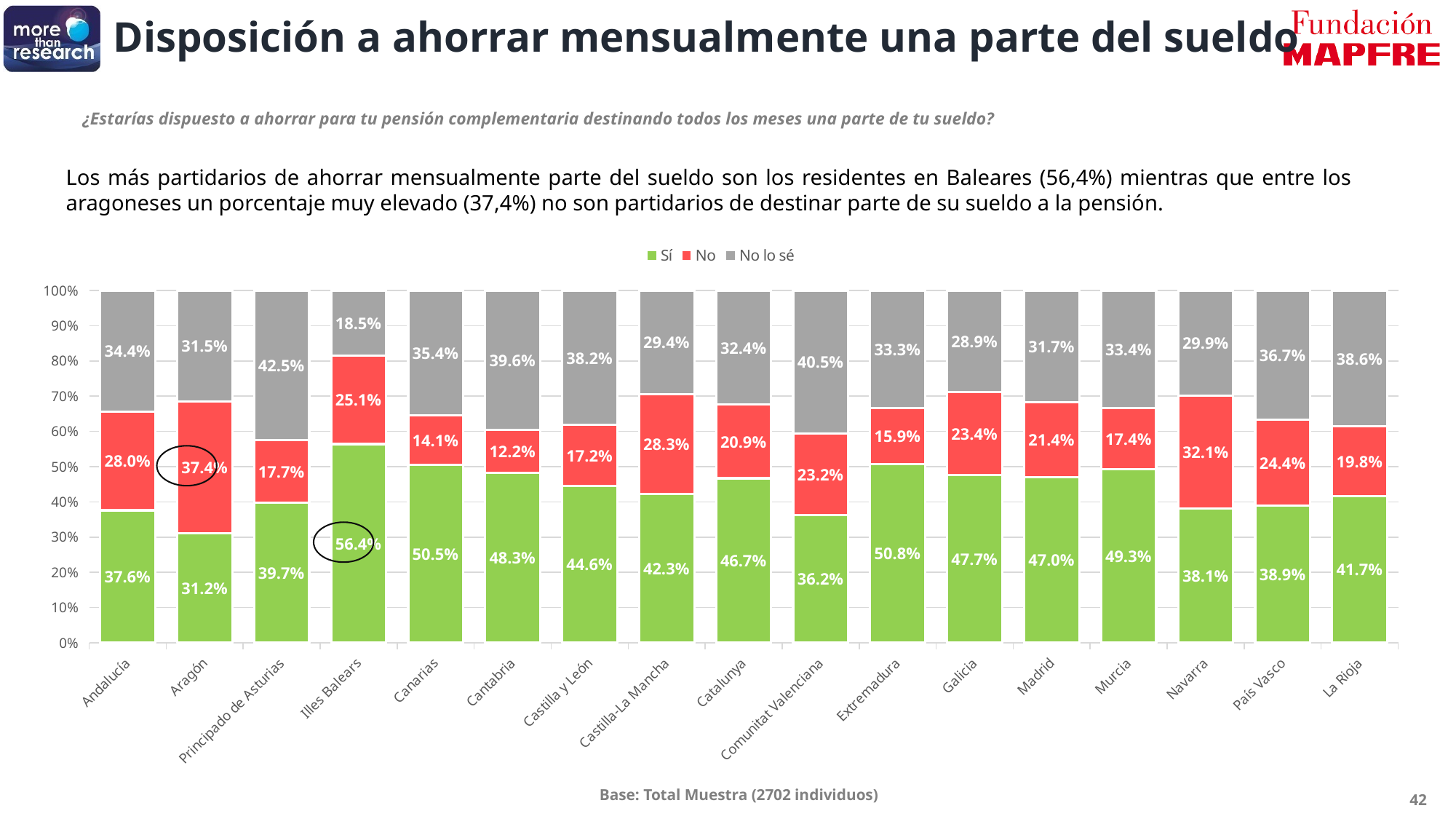
What is the difference between the "Sí" value for Illes Balears and the "Sí" value for Aragón? 25.2 percentage points How many regions are shown on the x axis? 17 What is the total of the stacked bar for Andalucía? 100.0% What is the "No" value for Aragón? 37.4% Which is larger: the "No" value for Navarra or the "No" value for Madrid? Navarra What kind of chart is shown on the slide? Stacked bar chart Which region has the lowest "Sí" percentage? Aragón How many series does the legend list? 3 Which region has the lowest "No" percentage? Cantabria What is the "No lo sé" value for Principado de Asturias? 42.5% What percentage of respondents in Illes Balears answered "Sí"? 56.4% Which region has the highest "Sí" percentage? Illes Balears